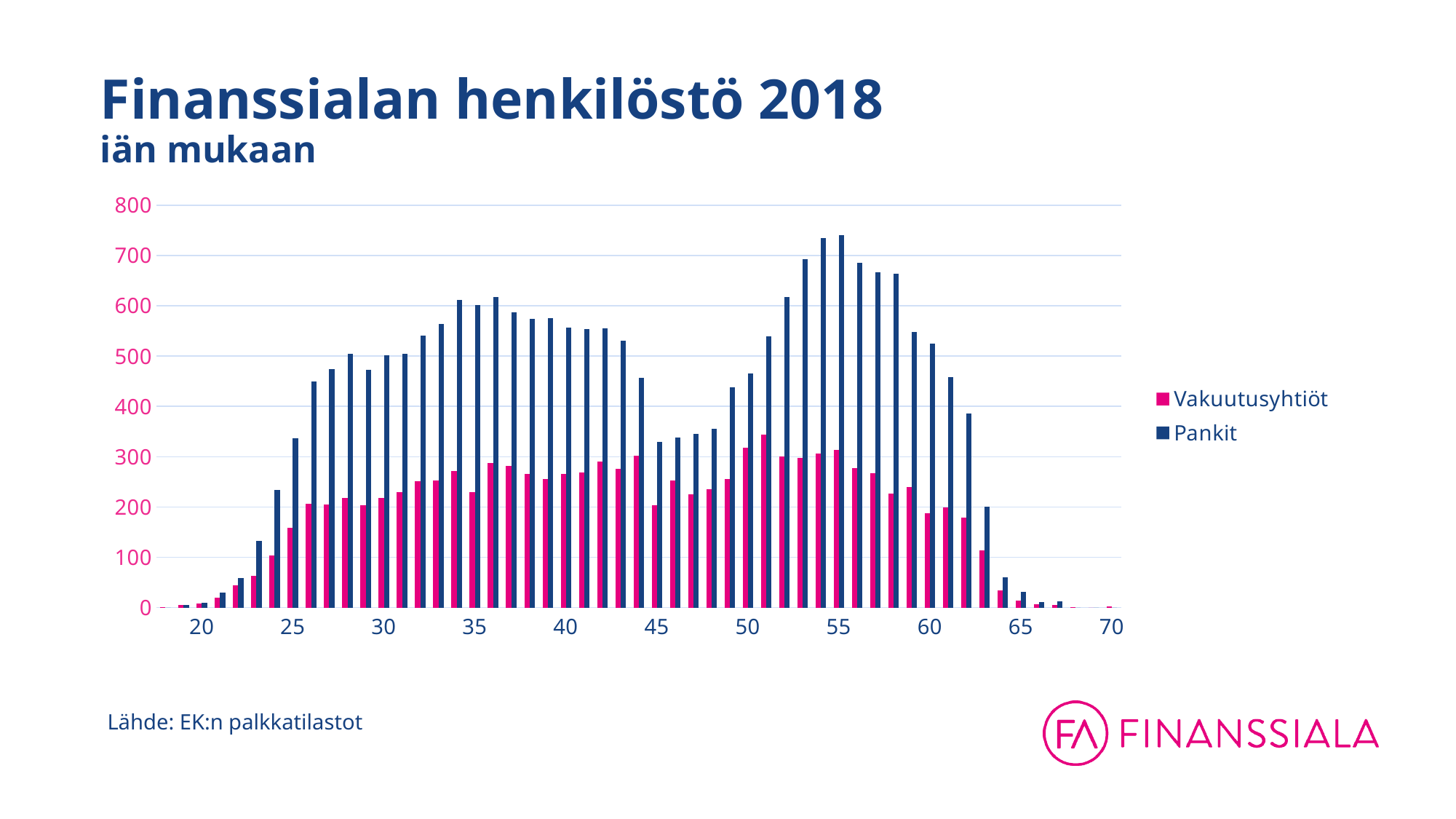
What kind of chart is shown on the slide? bar chart Is the Vakuutusyhtiöt value for age 51 greater or less than 300? greater What is the title of the chart? Finanssialan henkilöstö 2018 iän mukaan Which series has the larger value at age 55, Vakuutusyhtiöt or Pankit? Pankit Is the Pankit value for age 45 greater or less than 400? less Is the Pankit value for age 55 greater or less than 700? greater Do the Pankit values rise or fall from age 20 to age 25? rise Which age has the highest Vakuutusyhtiöt value? 51 How many series does the legend list? 2 Do the Pankit values rise or fall from age 55 to age 65? fall